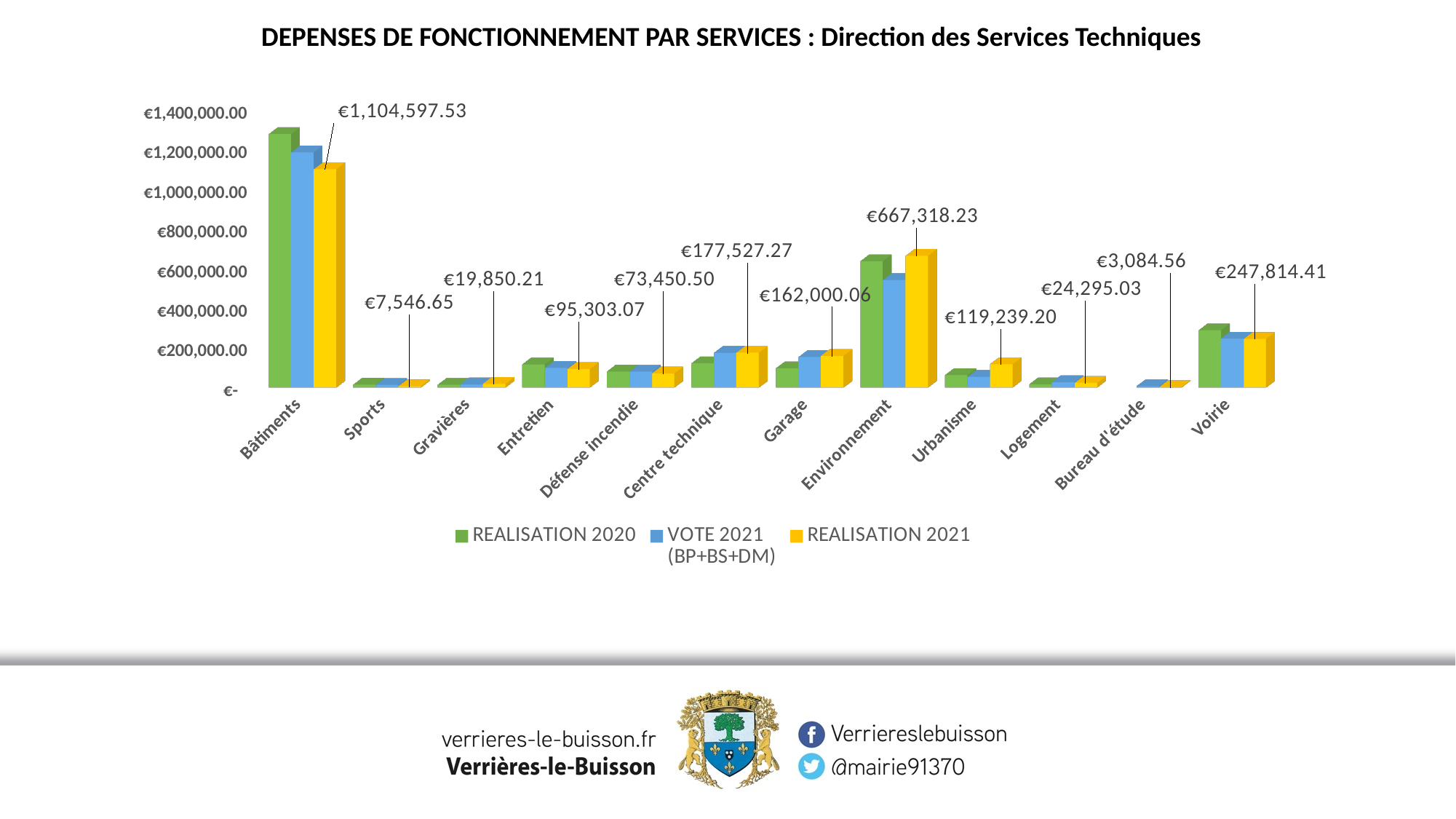
Is the REALISATION 2020 value for Bâtiments greater or less than €1,200,000.00? greater What is the difference between the REALISATION 2021 values for Centre technique and Garage? €15,527.21 What is the REALISATION 2021 value for Environnement? €667,318.23 How many services are shown on the x axis? 12 Which service has the lowest REALISATION 2021 value? Bureau d'étude What is the REALISATION 2021 value for Bureau d'étude? €3,084.56 Which has the larger REALISATION 2021 value, Urbanisme or Voirie? Voirie What is the REALISATION 2021 value for Bâtiments? €1,104,597.53 What is the REALISATION 2021 value for Voirie? €247,814.41 What kind of chart is shown on the slide? Bar chart Which service has the highest REALISATION 2021 value? Bâtiments How many series does the legend list? 3